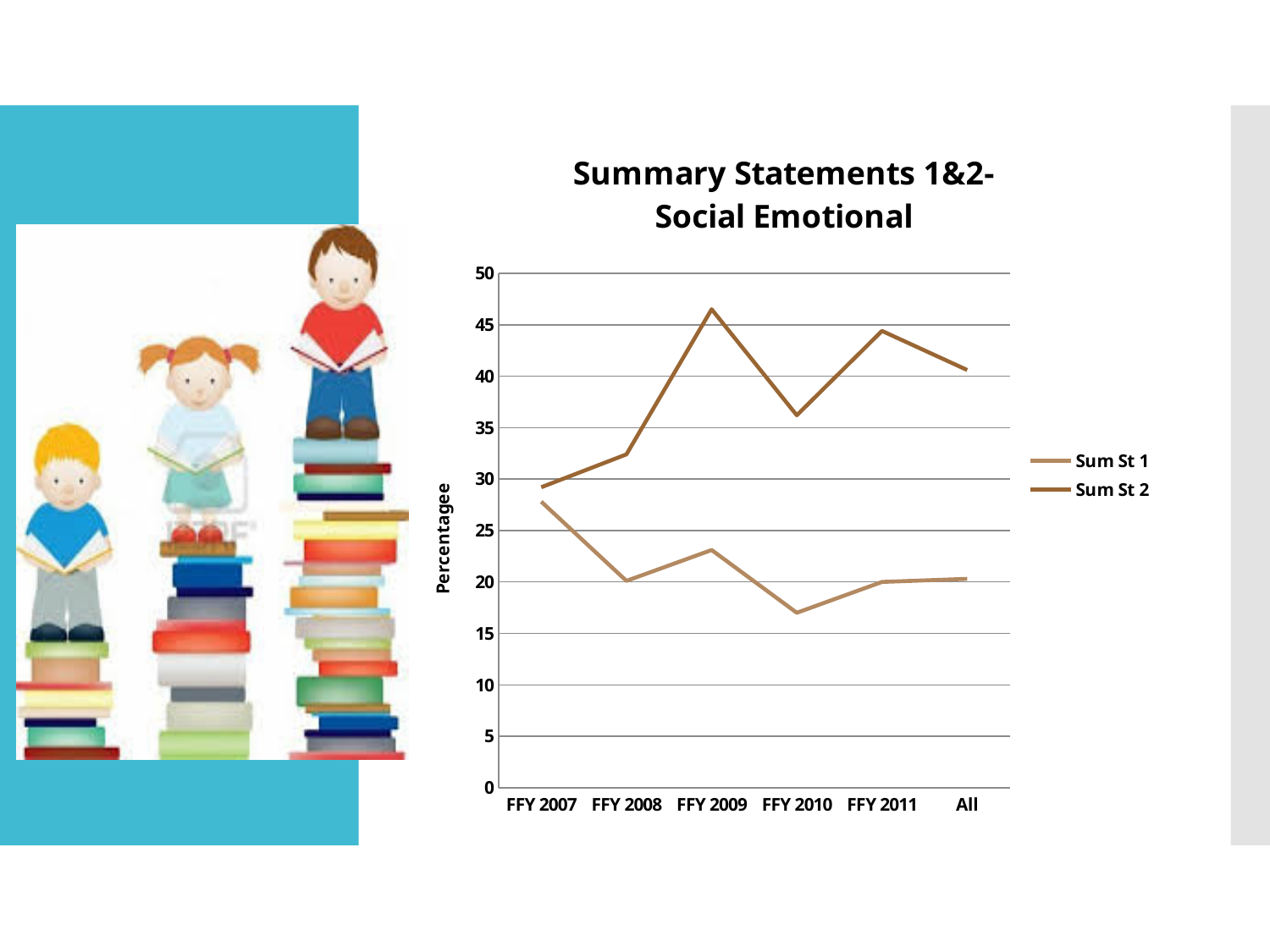
What is the label on the vertical axis? Percentagee For which category does Sum St 1 reach its highest value? FFY 2007 Is the value for Sum St 2 at FFY 2008 greater or less than 30? greater Is the value for Sum St 1 at FFY 2010 greater or less than 20? less Is the value for Sum St 2 at FFY 2009 greater or less than 45? greater For which category does Sum St 1 reach its lowest value? FFY 2010 At FFY 2009, which series has the larger value, Sum St 1 or Sum St 2? Sum St 2 What kind of chart is shown on the slide? line chart How many series does the legend list? 2 For which category does Sum St 2 reach its highest value? FFY 2009 Does the Sum St 1 line rise or fall from FFY 2007 to FFY 2008? fall How many categories are shown along the x axis? 6